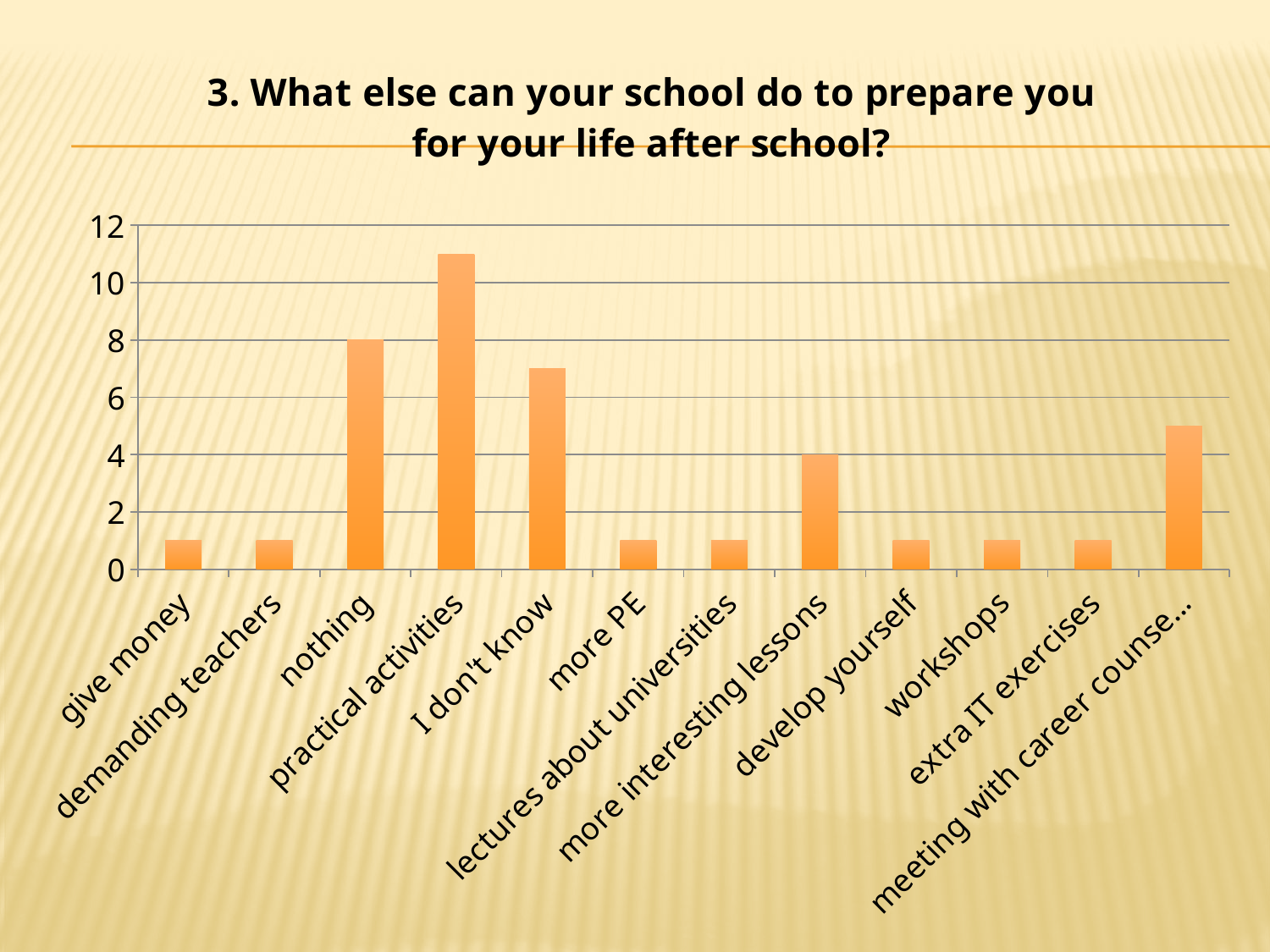
What is the value for "more interesting lessons"? 4 What is the difference between the values for "nothing" and "more interesting lessons"? 4 Which category has the highest value? practical activities What kind of chart is shown on the slide? bar chart What is the value for "nothing"? 8 Is the value for "I don't know" greater or less than 6? greater Is the value for "practical activities" greater or less than 10? greater Is the value for "give money" greater or less than 2? less Which is larger, the value for "nothing" or the value for "I don't know"? nothing How many categories are shown on the x axis? 12 What is the title of the chart? 3. What else can your school do to prepare you for your life after school? Which is larger, the value for "more interesting lessons" or the value for "workshops"? more interesting lessons